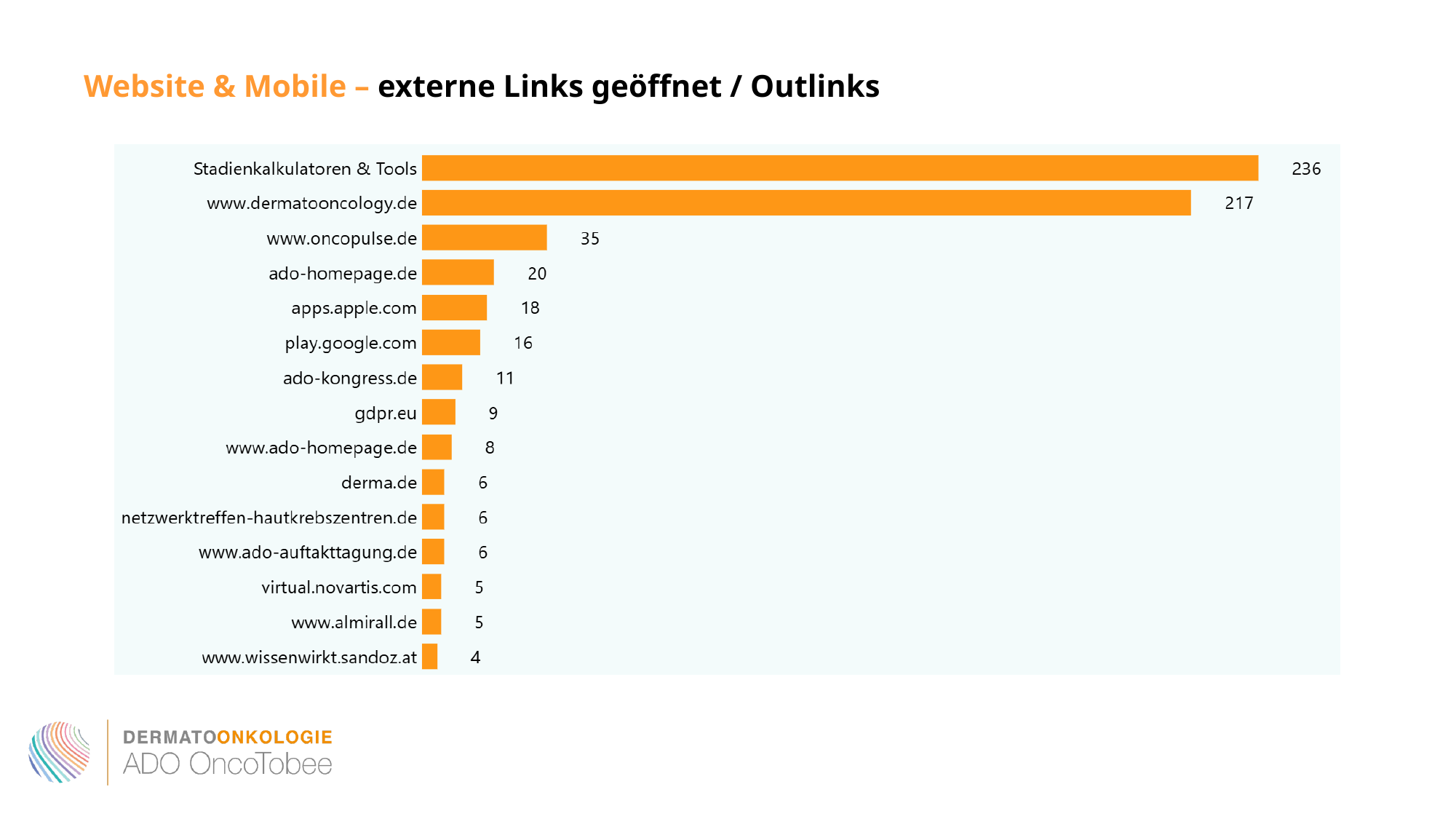
What kind of chart is shown on the slide? Bar chart Which category has the highest value? Stadienkalkulatoren & Tools What is the difference between the values for ado-homepage.de and apps.apple.com? 2 Which category has the lowest value? www.wissenwirkt.sandoz.at What is the value for play.google.com? 16 What is the difference between the values for Stadienkalkulatoren & Tools and www.dermatooncology.de? 19 What is the value for www.wissenwirkt.sandoz.at? 4 What colour are the bars in the chart? Orange What is the value for Stadienkalkulatoren & Tools? 236 Which is larger, the value for ado-kongress.de or the value for gdpr.eu? ado-kongress.de What is the value for www.oncopulse.de? 35 How many categories are shown in the chart? 15